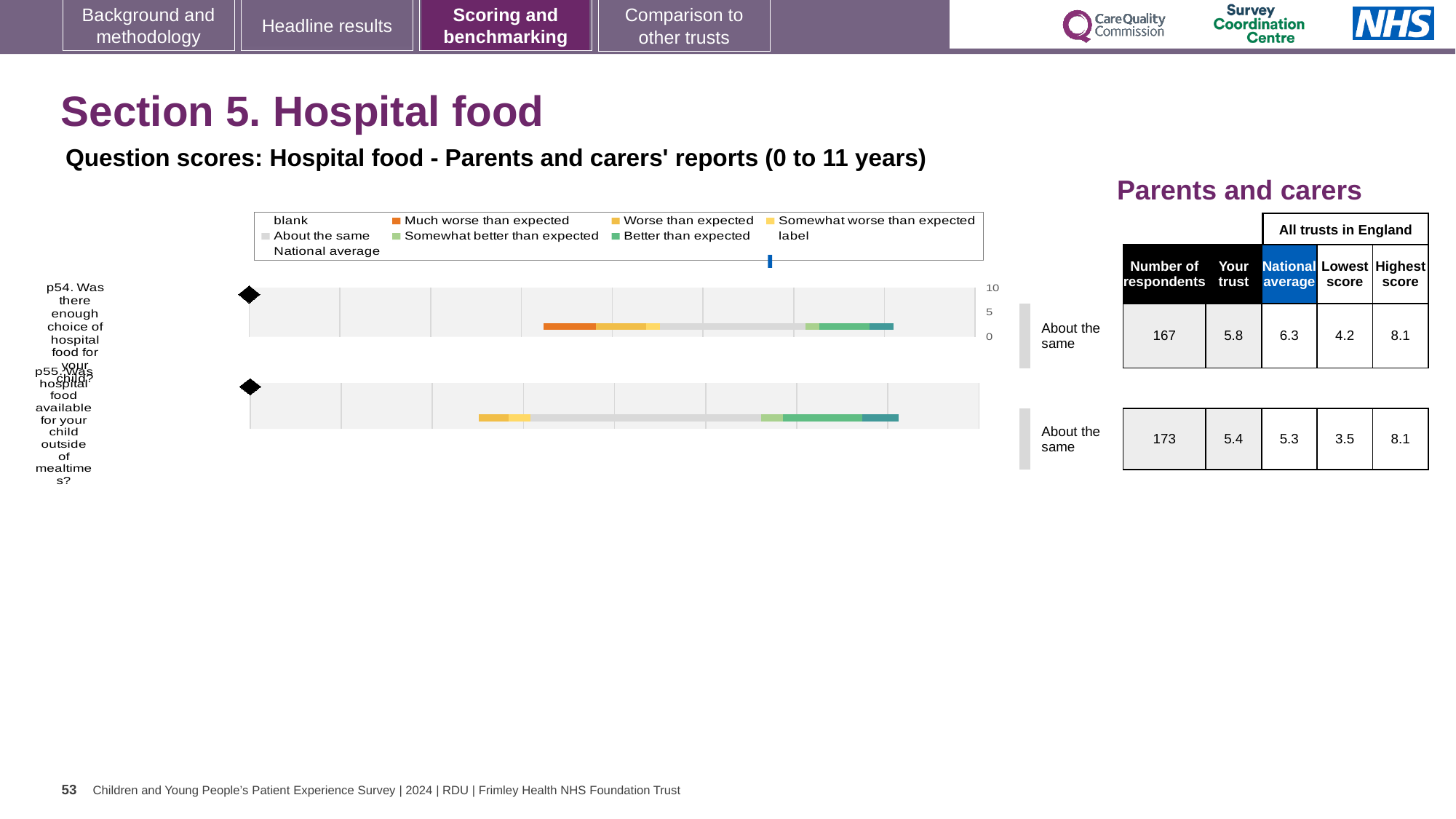
What is the highest score among all trusts in England for question p54? 8.1 What is the lowest score among all trusts in England for question p55? 3.5 What is the difference between the national average and the 'Your trust' score for question p54? 0.5 For question p55, which is higher: the 'Your trust' score or the national average? Your trust For question p54, which is higher: the 'Your trust' score or the national average? National average How many respondents answered question p55 (hospital food available outside of mealtimes)? 173 How many survey questions (categories) are plotted in the hospital food chart? 2 What is the 'Your trust' score for question p54 (enough choice of hospital food)? 5.8 What kind of chart is used to show the question scores for hospital food? bar chart What is the maximum value shown on the score axis of the chart? 10 What benchmark rating is shown next to the bar for question p55? About the same What is the national average score for question p54 (enough choice of hospital food)? 6.3